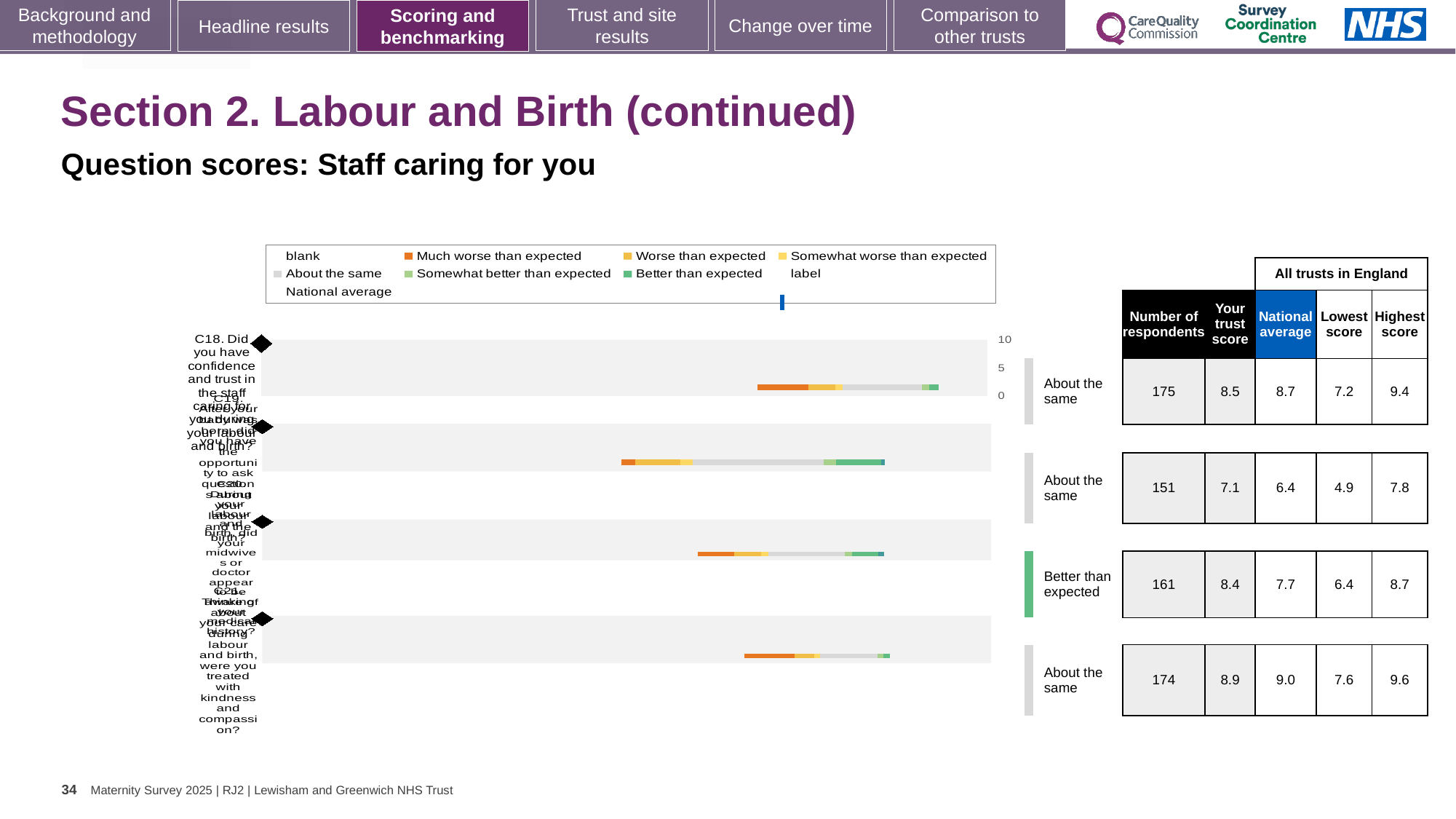
What is the highest score among all trusts in England for the fourth question (C21, treated with kindness and compassion)? 9.6 Which question row has the highest trust score? C21 (fourth row), 8.9 How many respondents answered the second question (C19)? 151 What is the trust score for the first question (C18, confidence and trust in the staff caring for you)? 8.5 What type of chart is shown on the slide? bar chart For the third question (C20), is the trust score or the national average larger? trust score (8.4) How many question bars are plotted in the chart? 4 What is the lowest score among all trusts in England for the second question (C19)? 4.9 Which question row is rated 'Better than expected'? C20 (third row) Which question row has the lowest trust score? C19 (second row), 7.1 What is the difference between the highest trust score (8.9) and the lowest trust score (7.1)? 1.8 What is the national average for the first question (C18)? 8.7